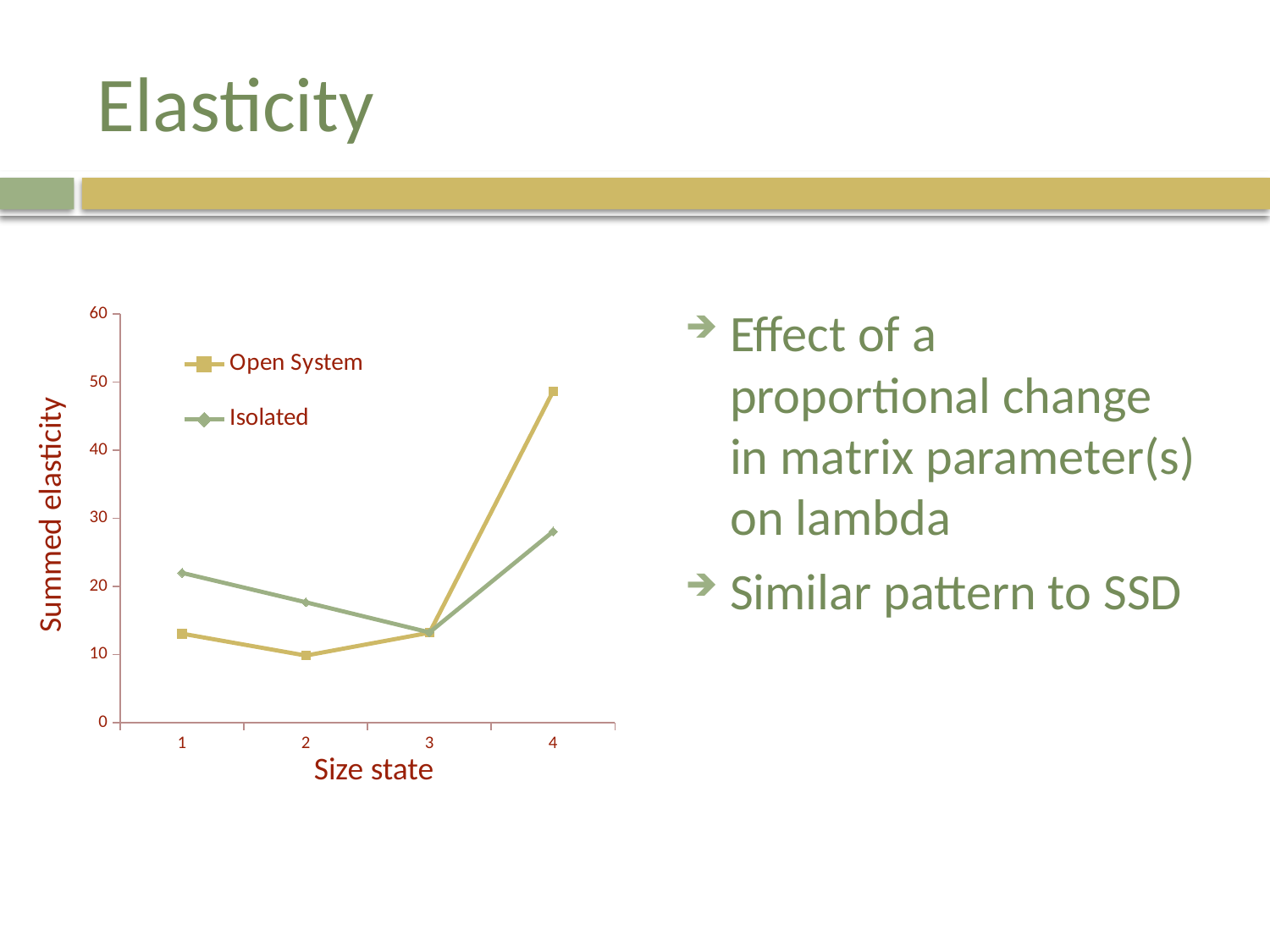
What is the label on the vertical axis of the chart? Summed elasticity At which size state does the Open System series reach its lowest value? 2 How many series does the chart legend list? 2 At which size state does the Open System series reach its highest value? 4 Is the Isolated value at size state 4 greater or less than 30? less What kind of chart is shown on the slide? line chart At which size state does the Isolated series reach its lowest value? 3 At which size state does the Isolated series reach its highest value? 4 At size state 4, which series has the larger summed elasticity, Open System or Isolated? Open System At size state 1, which series has the larger summed elasticity, Open System or Isolated? Isolated How many size states are plotted along the x axis? 4 Is the Open System value at size state 4 greater or less than 40? greater